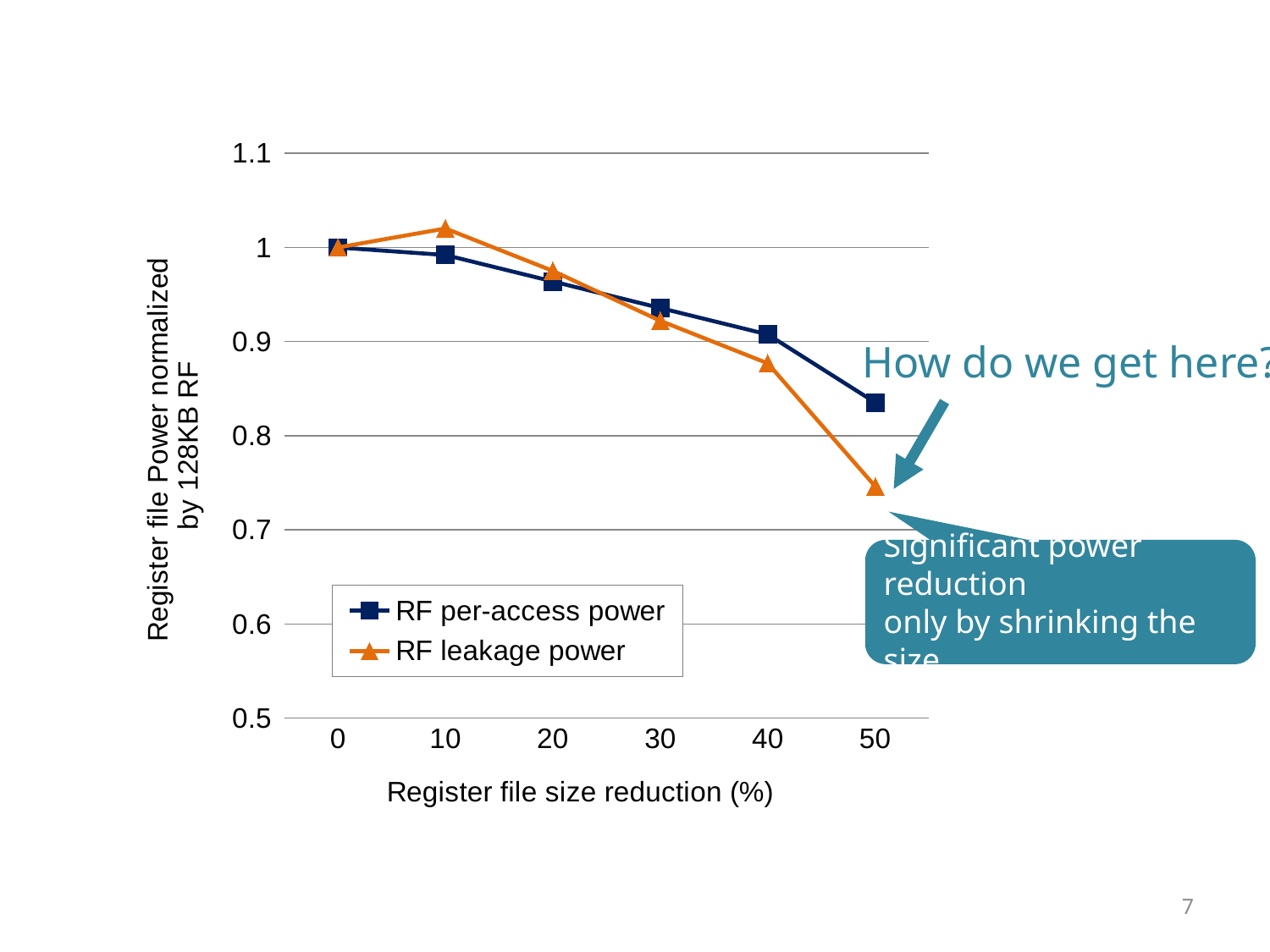
Is the value of RF leakage power at 50% register file size reduction greater or less than 0.8? less How many series does the legend list? 2 Is the value of RF per-access power at 50% register file size reduction greater or less than 0.8? greater At which register file size reduction is RF leakage power lowest? 50 What is the value of RF per-access power at 0% register file size reduction? 1 What kind of chart is shown on the slide? line chart What is the title of the x axis? Register file size reduction (%) At 50% register file size reduction, which series has the larger value, RF per-access power or RF leakage power? RF per-access power At 10% register file size reduction, which series has the larger value, RF per-access power or RF leakage power? RF leakage power Is the value of RF leakage power at 10% register file size reduction greater or less than 1? greater How many register file size reduction values are plotted along the x axis? 6 Does RF leakage power rise or fall overall as register file size reduction increases from 0 to 50? fall